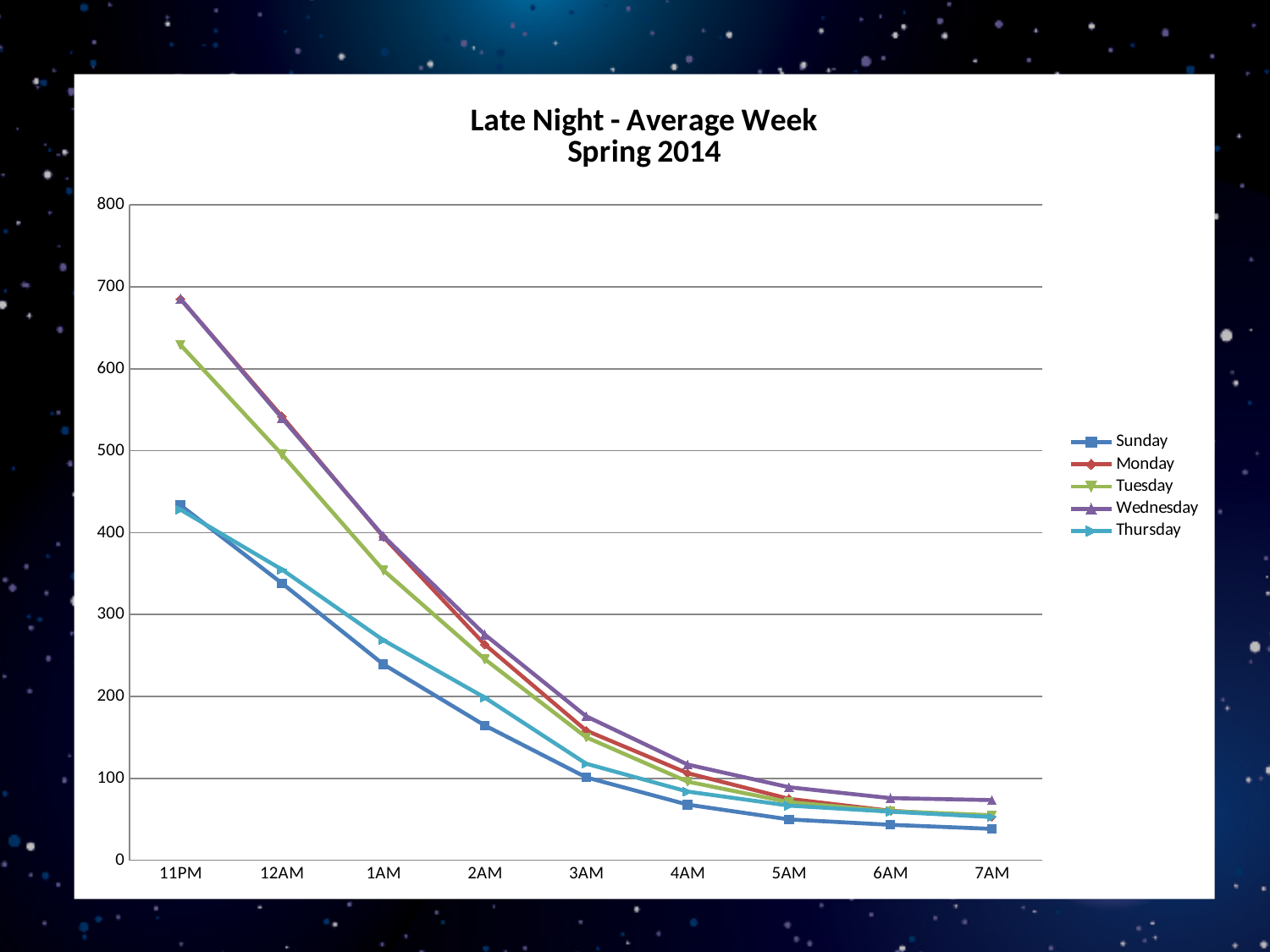
Which day has the highest value at 7AM? Wednesday Is the value for Sunday at 2AM greater or less than 200? less Do the values for each day rise or fall from 11PM to 7AM? Fall How many series does the legend list? 5 Is the value for Thursday at 12AM greater or less than 300? greater What is the title of the chart? Late Night - Average Week Spring 2014 What kind of chart is shown on the slide? Line chart How many time points are plotted along the x axis? 9 Which day has the lowest value at 7AM? Sunday At 12AM, which is larger: the value for Tuesday or the value for Sunday? Tuesday Is the value for Tuesday at 11PM greater or less than 600? greater